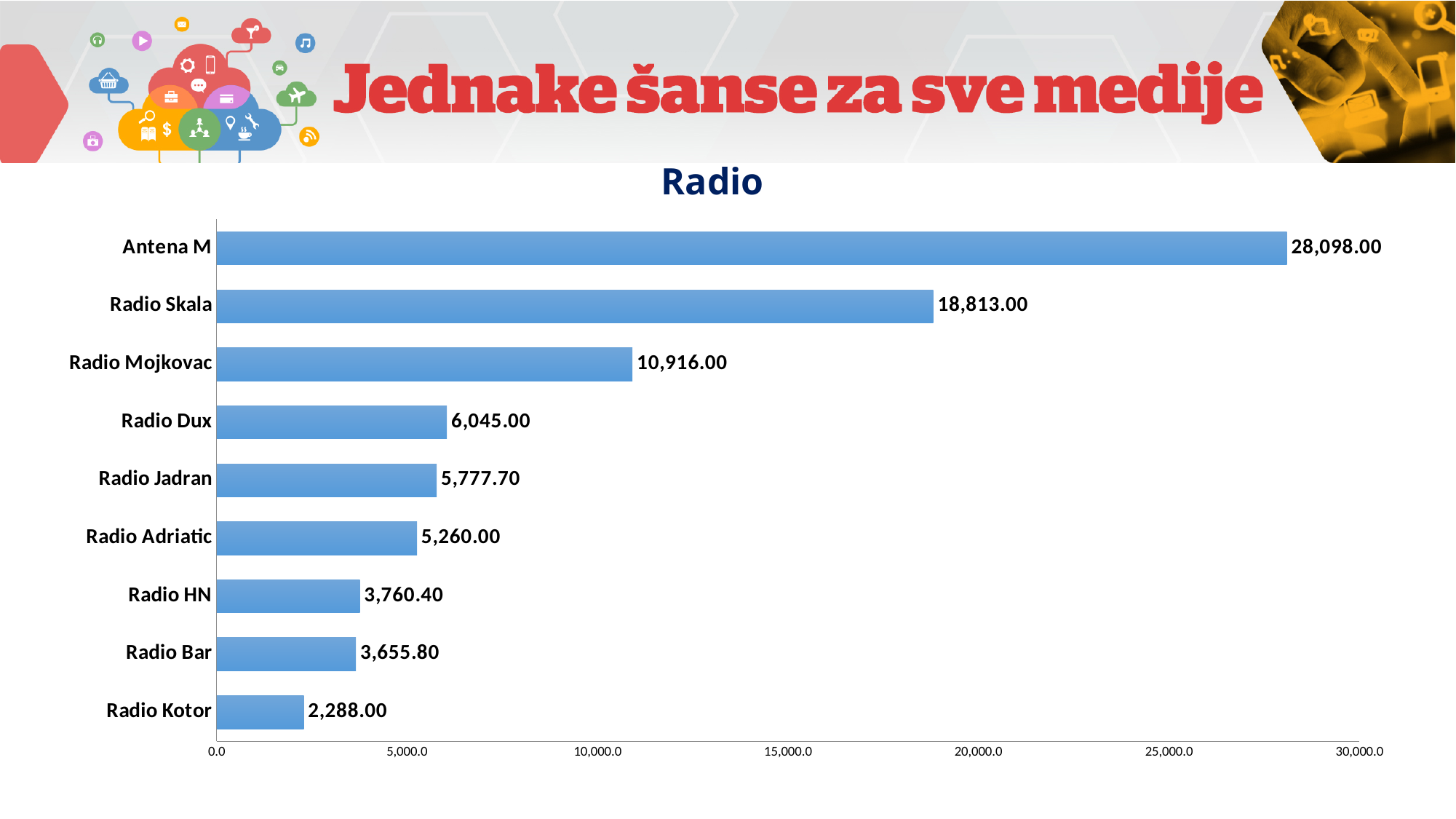
What is the difference between the values for Antena M and Radio Skala? 9,285.00 Which radio station has the highest value? Antena M Is the value for Radio Skala greater or less than 20,000.0? less What is the difference between the values for Radio HN and Radio Bar? 104.60 What kind of chart is shown on the slide? bar chart Which has a larger value, Radio Mojkovac or Radio Dux? Radio Mojkovac What is the title of the chart? Radio How many radio stations are shown in the chart? 9 Which radio station has the lowest value? Radio Kotor What is the value for Radio HN? 3,760.40 What is the value for Antena M? 28,098.00 What is the value for Radio Jadran? 5,777.70